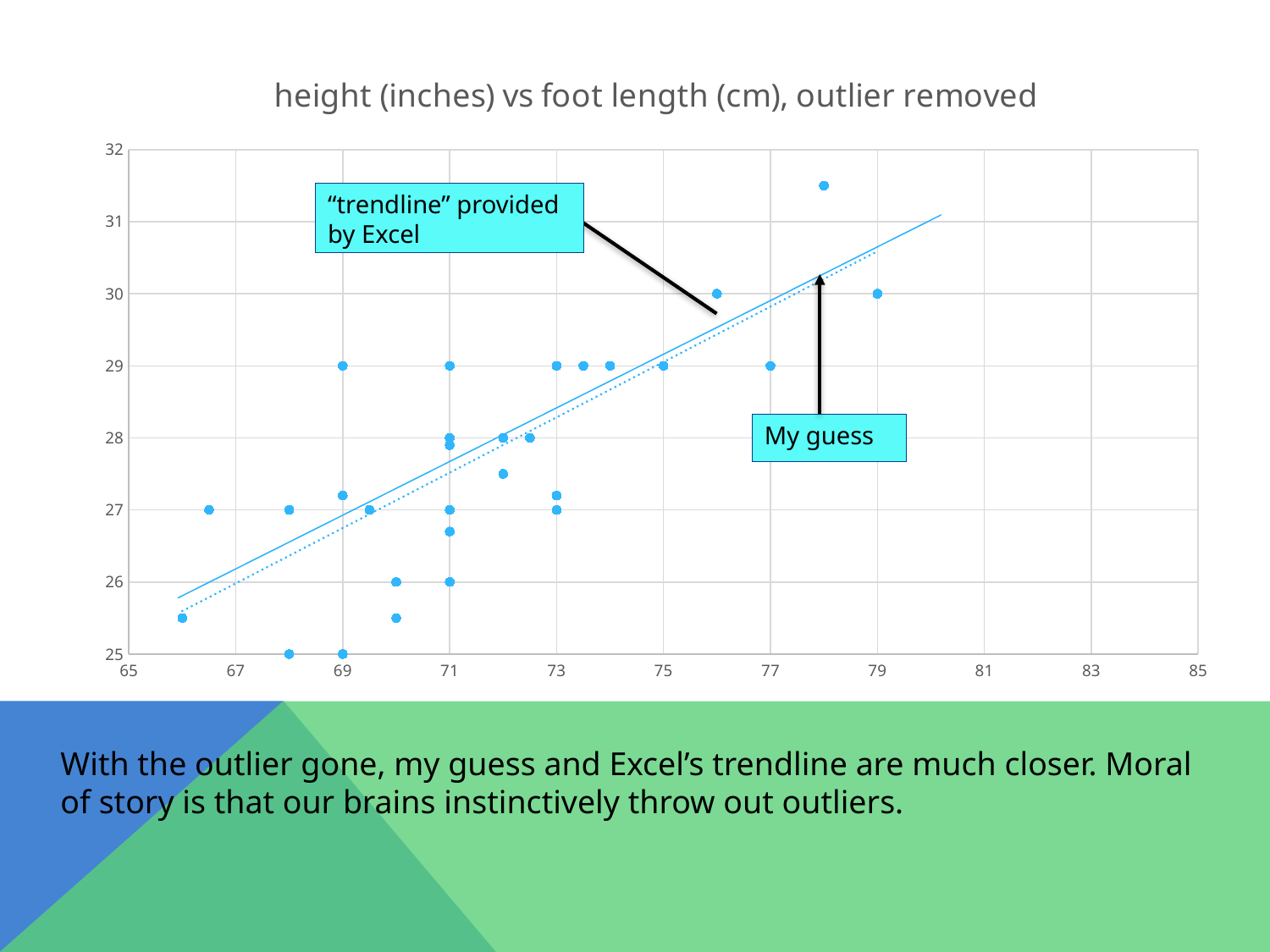
What foot length is plotted for the point at height 75? 29 What is the title of the chart? height (inches) vs foot length (cm), outlier removed Which point has the larger foot length, the one at height 78 or the one at height 79? 78 What kind of chart is shown on the slide? scatter plot What foot length is plotted for the point at height 76? 30 What does the dotted line on the chart represent? My guess Is the foot length for the point at height 78 greater or less than 31? greater What foot length is plotted for the point at height 79? 30 What is the lowest foot length value plotted on the chart? 25 Is the foot length for the point at height 66 greater or less than 26? less Do the plotted foot length values generally rise or fall as height increases along the x axis? rise